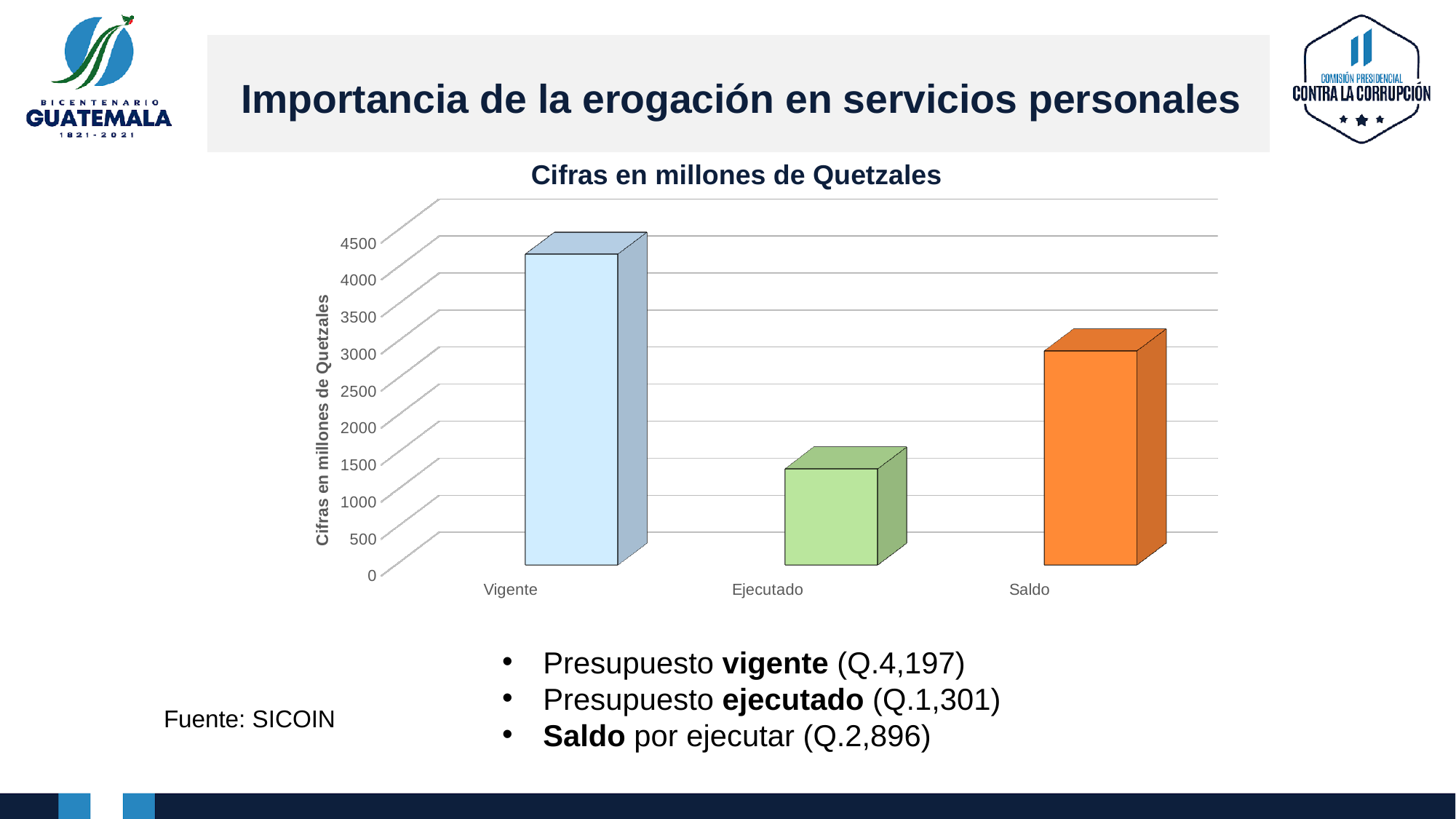
What is the label of the vertical axis of the chart? Cifras en millones de Quetzales Is the value for Ejecutado greater or less than 1500? less According to the slide, what is the value of the presupuesto vigente? Q.4,197 What type of chart is shown on the slide? Bar chart Which category has the lowest bar in the chart? Ejecutado What is the title of the chart? Cifras en millones de Quetzales According to the slide, what is the value of the presupuesto ejecutado? Q.1,301 Is the value for Saldo greater or less than 2500? greater How many categories are shown on the x axis of the chart? 3 Is the value for Vigente greater or less than 4000? greater Which category has the highest bar in the chart? Vigente Which is larger, the value for Saldo or the value for Ejecutado? Saldo